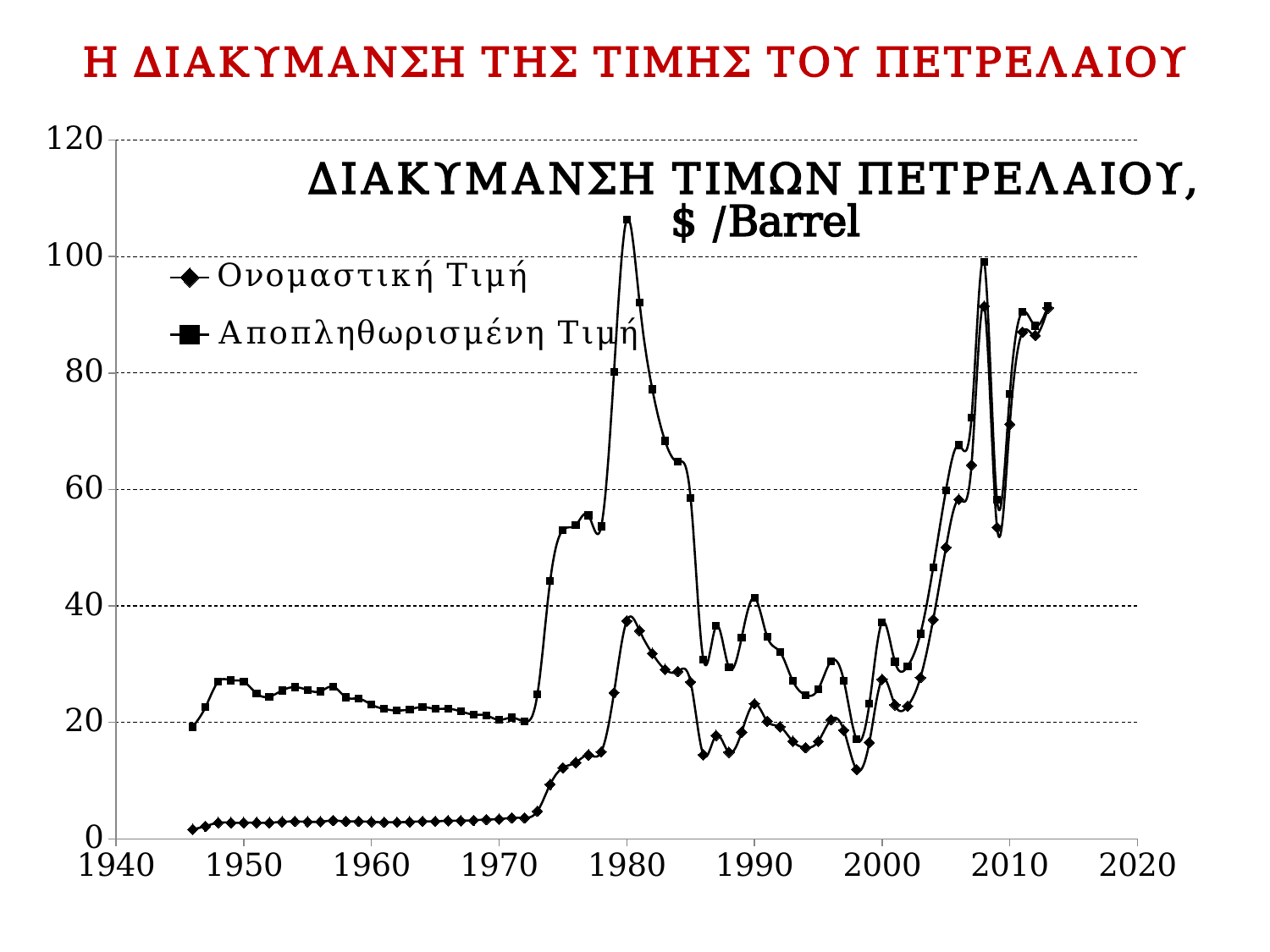
Is the value of Αποπληθωρισμένη Τιμή in 1950 greater or less than 20? greater What unit is given in the chart title? $ /Barrel Does Αποπληθωρισμένη Τιμή rise or fall between 1980 and 1986? fall Is the value of Ονομαστική Τιμή in 1980 greater or less than 40? less In 1980, which series has the higher value, Ονομαστική Τιμή or Αποπληθωρισμένη Τιμή? Αποπληθωρισμένη Τιμή Which series reaches the highest value anywhere on the chart? Αποπληθωρισμένη Τιμή Is the value of Ονομαστική Τιμή in 1950 greater or less than 20? less How many series does the legend list? 2 What kind of chart is shown on the slide? Line chart Which series is marked with square markers in the legend? Αποπληθωρισμένη Τιμή